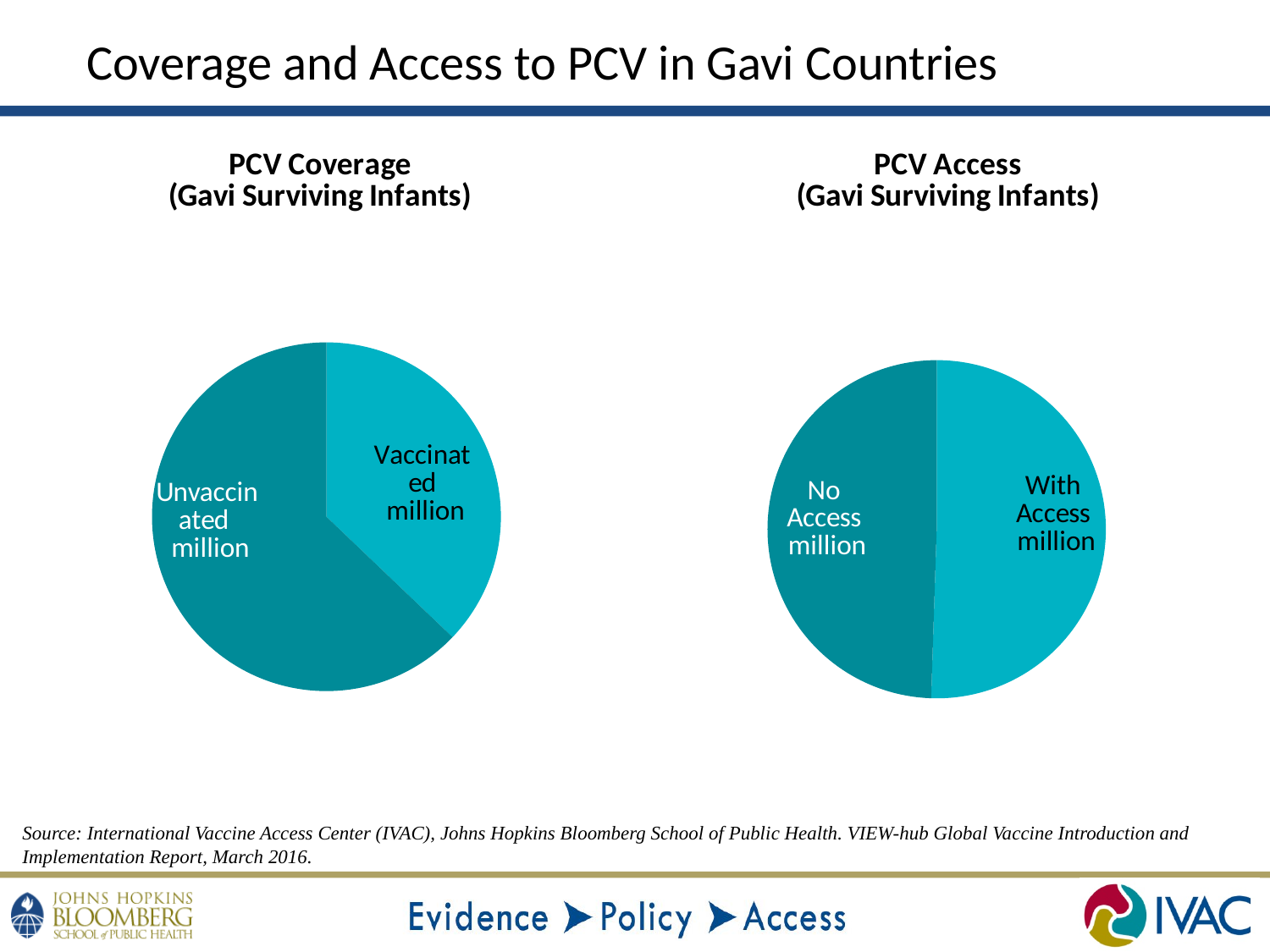
What is the title of the pie chart on the left of the slide? PCV Coverage (Gavi Surviving Infants) In the PCV Coverage (Gavi Surviving Infants) chart, which slice is larger, Vaccinated or Unvaccinated? Unvaccinated In the PCV Coverage (Gavi Surviving Infants) chart, which slice is the smallest? Vaccinated In the PCV Coverage (Gavi Surviving Infants) chart, which slice is the largest? Unvaccinated How many pie charts are shown on the slide? 2 How many slices does the PCV Coverage (Gavi Surviving Infants) pie chart have? 2 How many slices does the PCV Access (Gavi Surviving Infants) pie chart have? 2 What are the two slices labelled in the PCV Access (Gavi Surviving Infants) chart? No Access and With Access What kind of chart is the PCV Coverage (Gavi Surviving Infants) chart? Pie chart What kind of chart is the PCV Access (Gavi Surviving Infants) chart? Pie chart